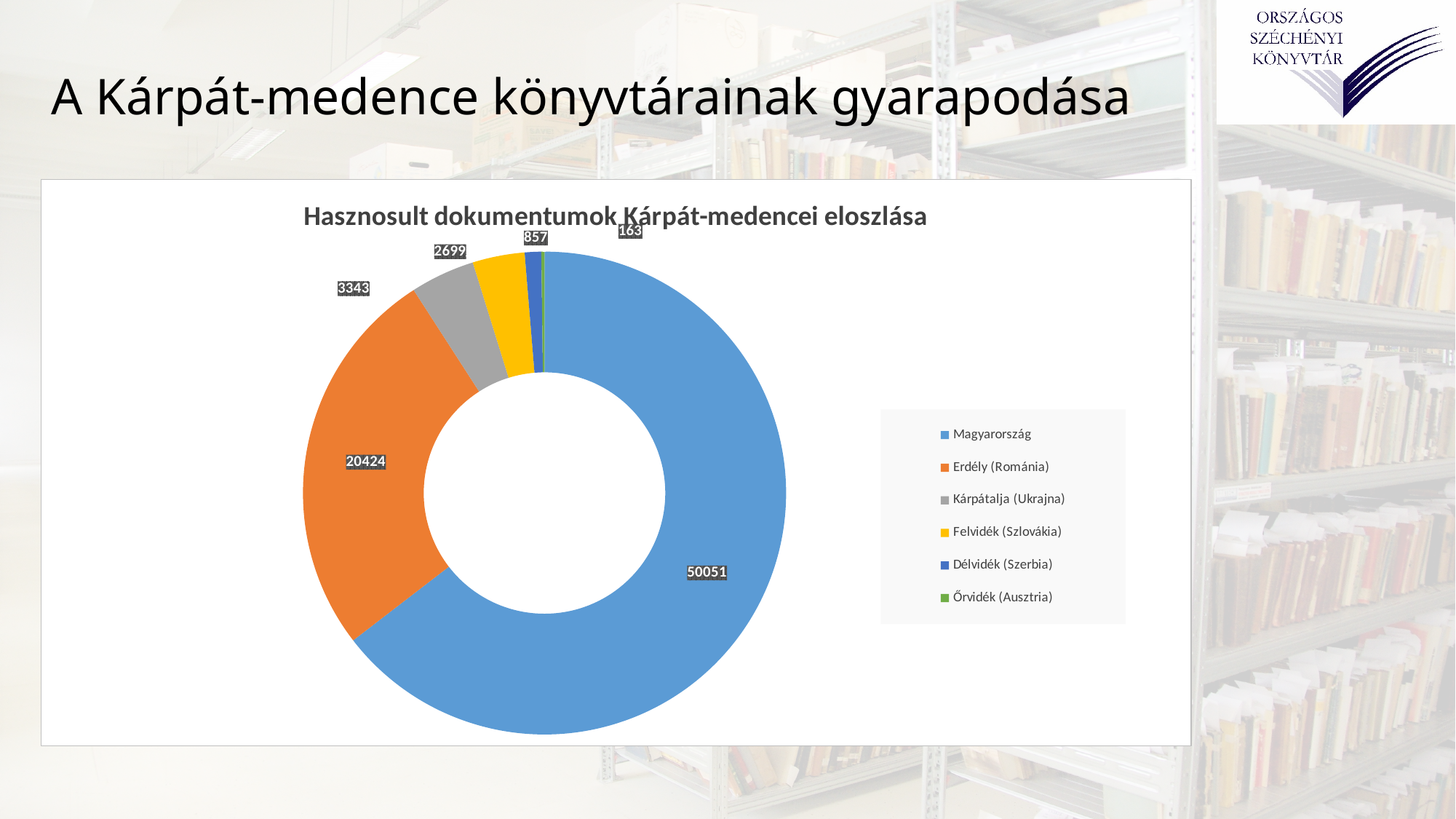
What is the difference between the values for Magyarország and Erdély (Románia)? 29627 Which category has the smallest value in the chart? Őrvidék (Ausztria) What kind of chart is shown on the slide? doughnut chart What is the value for Őrvidék (Ausztria) in the chart? 163 Which category has the largest value in the chart? Magyarország Which is larger, the value for Kárpátalja (Ukrajna) or the value for Felvidék (Szlovákia)? Kárpátalja (Ukrajna) How many categories does the chart show? 6 What is the value for Kárpátalja (Ukrajna) in the chart? 3343 What is the title of the chart? Hasznosult dokumentumok Kárpát-medencei eloszlása What is the value for Erdély (Románia) in the chart? 20424 What is the difference between the values for Délvidék (Szerbia) and Őrvidék (Ausztria)? 694 What is the value for Magyarország in the chart? 50051